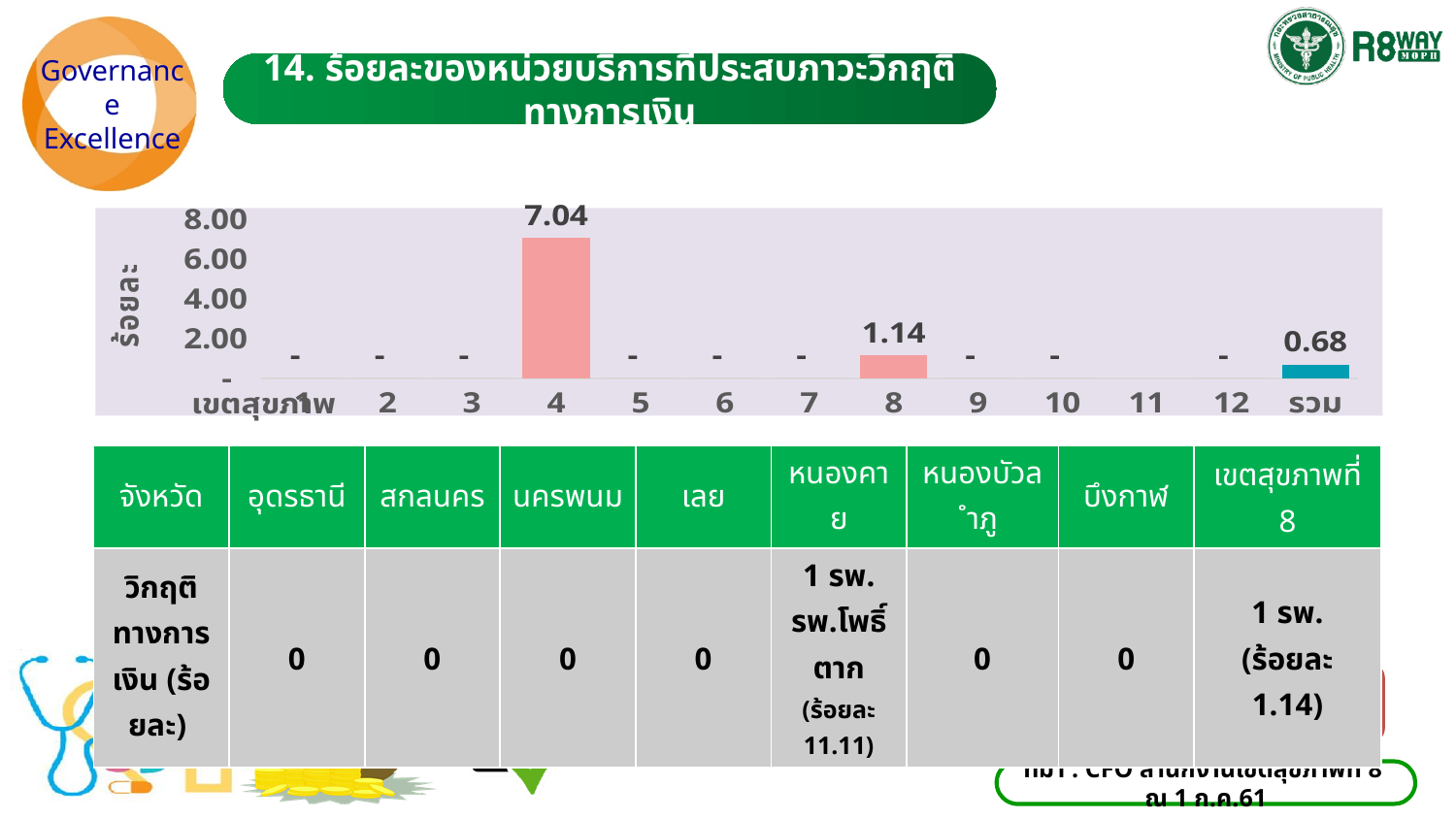
Is the value for health region 4 greater or less than 6.00? greater What kind of chart is shown on the slide? bar chart Which is larger in the bar chart, the value for health region 8 or the value for รวม? health region 8 How many categories are shown on the x axis of the bar chart? 13 What is the value shown for health region 2 in the bar chart? - What is the label on the vertical axis of the bar chart? ร้อยละ What is the difference between the values for health region 4 and health region 8 in the bar chart? 5.90 Which category has the highest value in the bar chart? 4 What is the value for health region 4 (เขต 4) in the bar chart? 7.04 What is the value for the รวม (total) category in the bar chart? 0.68 What is the value for health region 8 (เขต 8) in the bar chart? 1.14 Is the value for health region 8 greater or less than 2.00? less